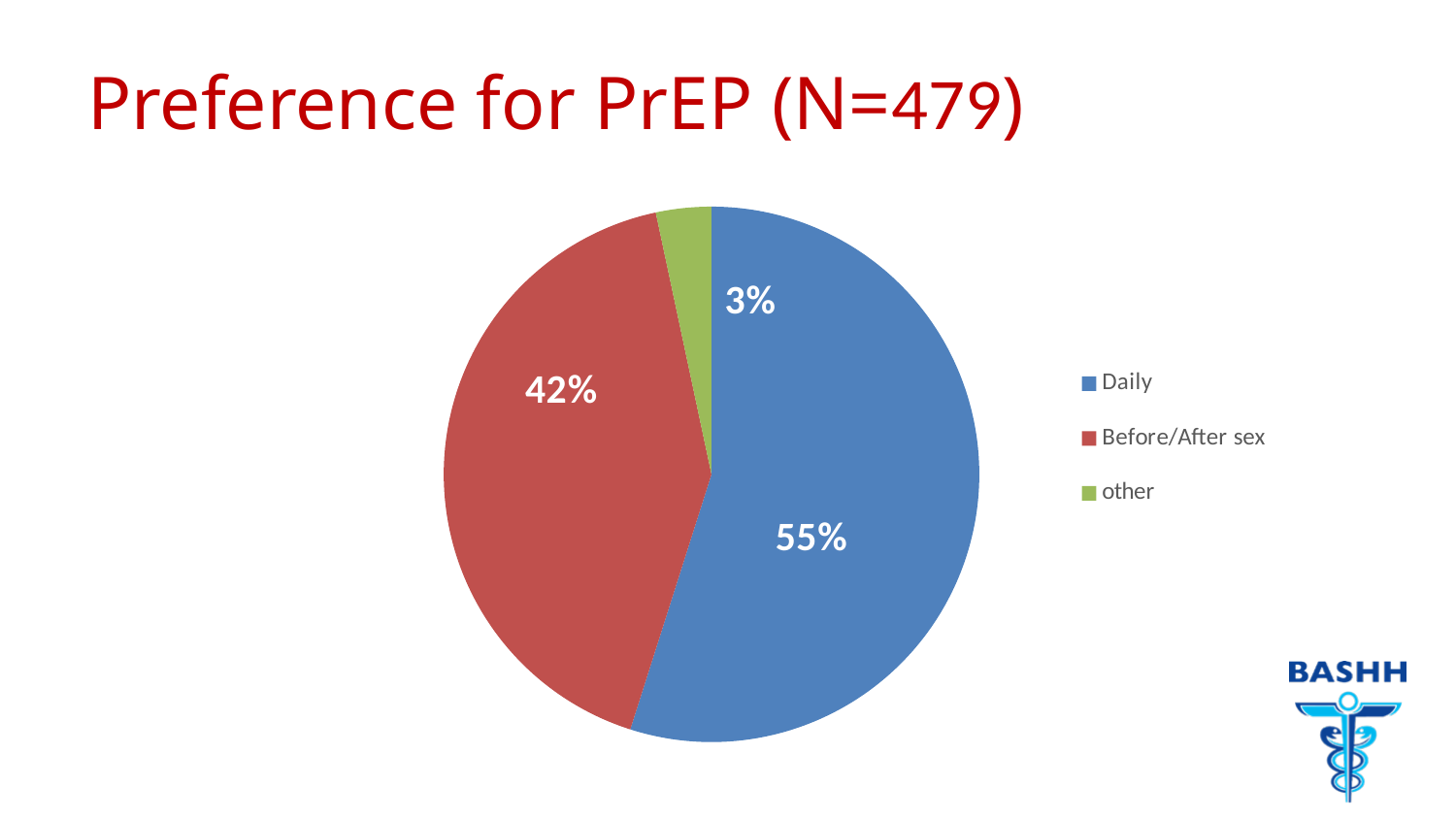
What share of the pie is labelled Before/After sex? 42% Which category has the largest slice of the pie? Daily How many entries does the legend list? 3 What share of the pie is labelled Daily? 55% How many categories does the pie chart show? 3 Which slice is larger, Before/After sex or other? Before/After sex What share of the pie is labelled other? 3% Which category has the smallest slice of the pie? other What is the difference in percentage points between the Daily and Before/After sex slices? 13 What colour is the Daily slice of the pie? Blue What kind of chart is shown on the slide? Pie chart What is the title of the slide containing the chart? Preference for PrEP (N=479)